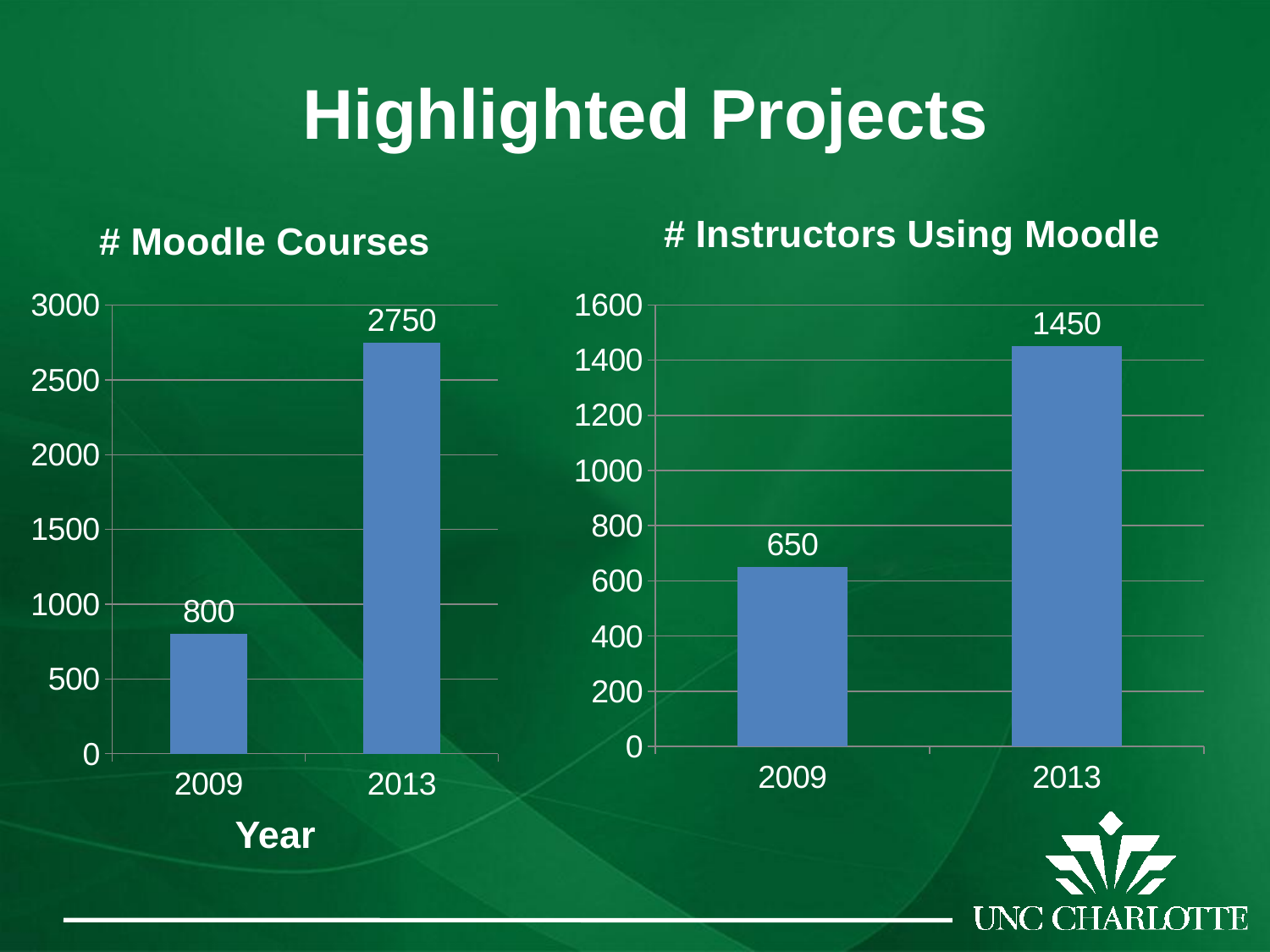
In the '# Instructors Using Moodle' chart, what is the difference between the 2013 and 2009 values? 800 In the '# Moodle Courses' chart, what is the difference between the 2013 and 2009 values? 1950 In the '# Moodle Courses' chart, which year has the highest value? 2013 What kind of chart is the '# Instructors Using Moodle' chart? bar chart In the '# Moodle Courses' chart, do the values rise or fall from 2009 to 2013? rise In the '# Instructors Using Moodle' chart, which year has the lowest value? 2009 In the '# Moodle Courses' chart, what is the value for 2013? 2750 How many bars are shown in the '# Moodle Courses' chart? 2 In the '# Moodle Courses' chart, what is the value for 2009? 800 In the '# Instructors Using Moodle' chart, is the value for 2009 greater or less than 800? less In the '# Instructors Using Moodle' chart, what is the value for 2013? 1450 In the '# Instructors Using Moodle' chart, what is the value for 2009? 650